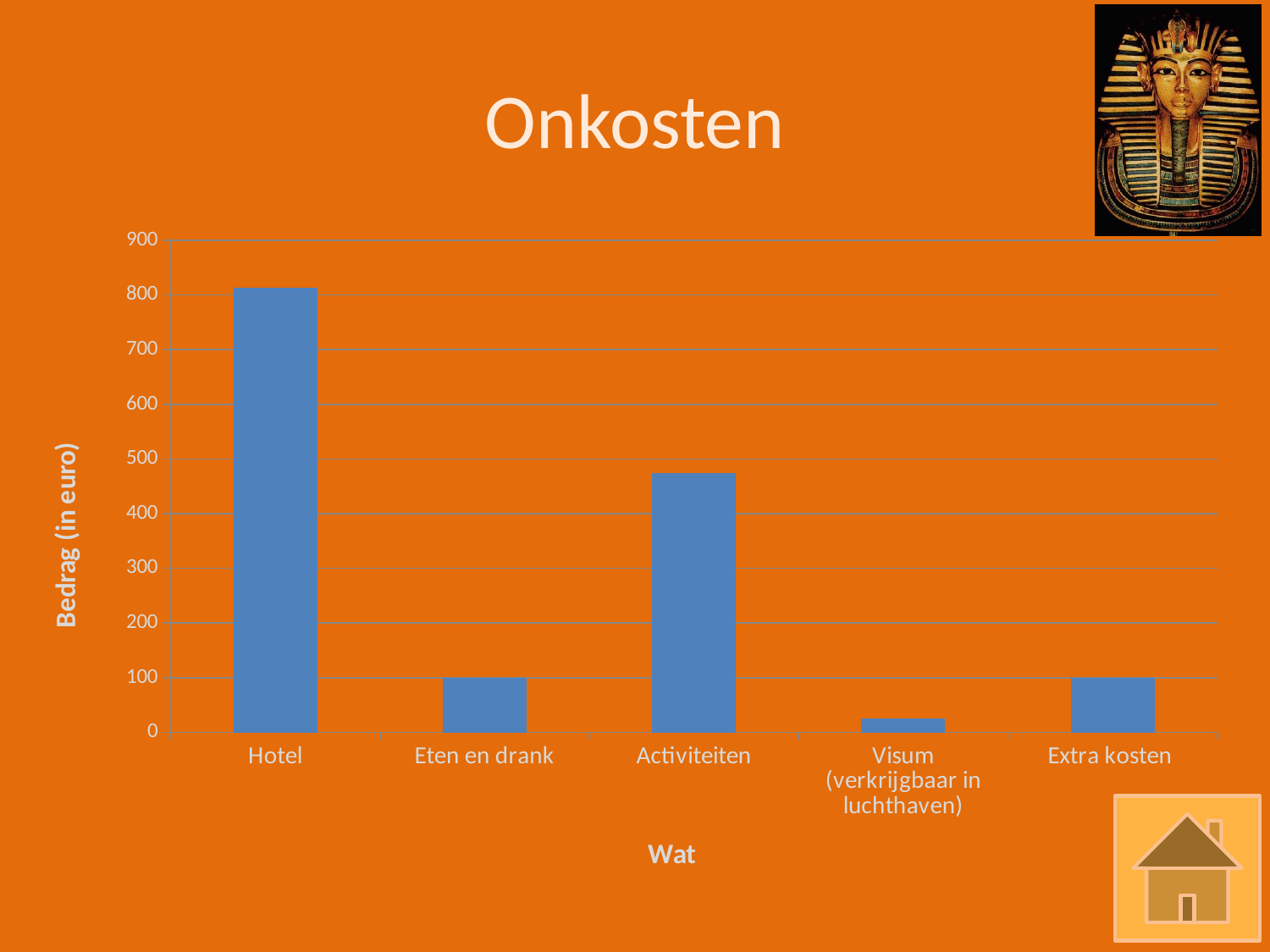
Is the value for Activiteiten greater or less than 400? greater What is the label of the vertical axis? Bedrag (in euro) Which category has the lowest value in the chart? Visum (verkrijgbaar in luchthaven) What is the title of the chart? Onkosten Which is larger, the value for Hotel or the value for Activiteiten? Hotel Is the value for Visum (verkrijgbaar in luchthaven) greater or less than 100? less What is the value for Eten en drank? 100 What kind of chart is shown on the slide? bar chart Is the value for Hotel greater or less than 800? greater How many categories are shown on the x axis of the chart? 5 Which category has the highest value in the chart? Hotel